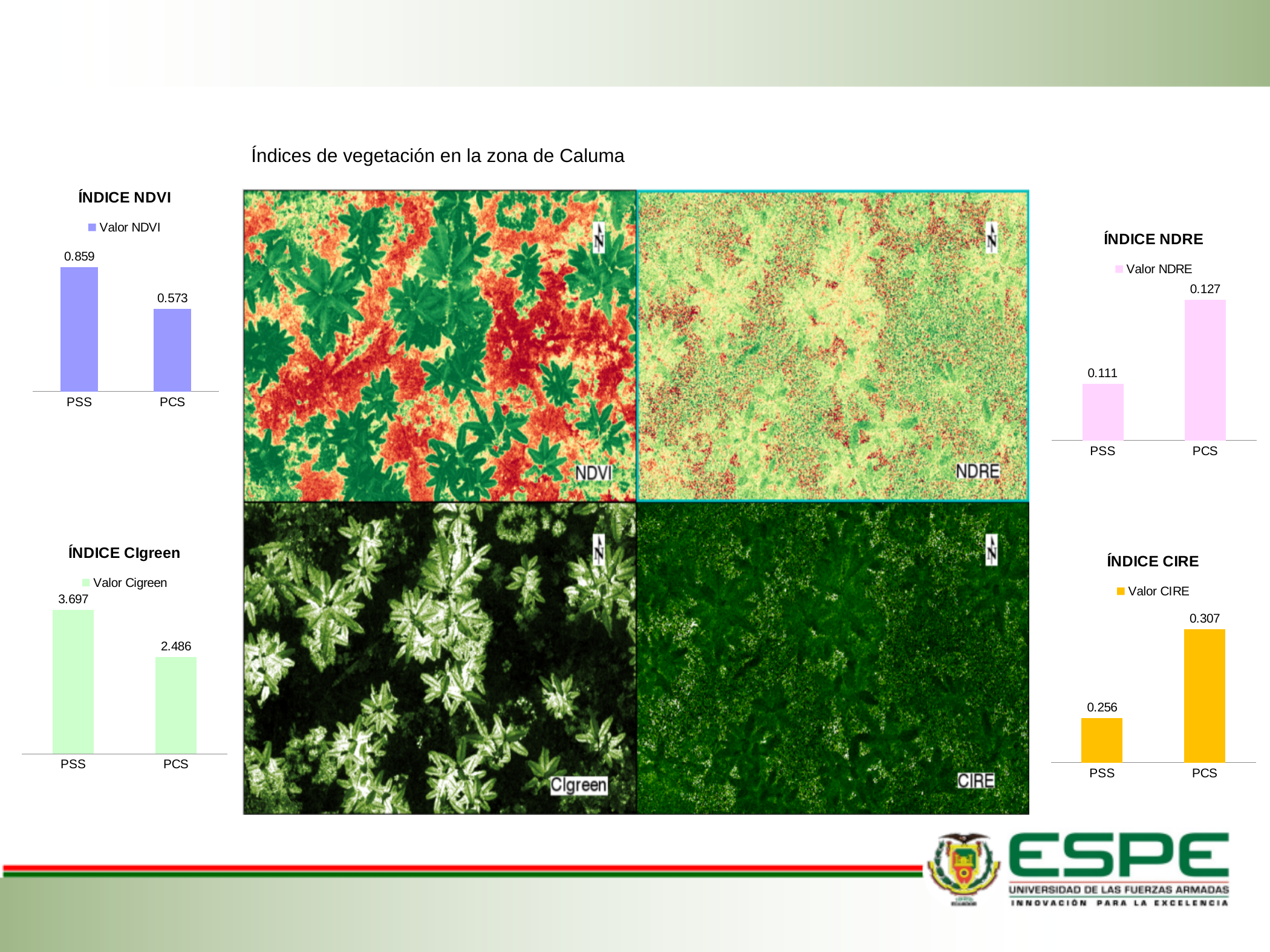
What kind of chart is the ÍNDICE NDVI chart? Bar chart In the ÍNDICE CIgreen chart, which category has the lowest value? PCS In the ÍNDICE CIgreen chart, what is the value for PSS? 3.697 In the ÍNDICE CIRE chart, which is larger, the value for PSS or the value for PCS? PCS In the ÍNDICE NDVI chart, what is the value for PCS? 0.573 In the ÍNDICE CIRE chart, what is the value for PCS? 0.307 In the ÍNDICE CIgreen chart, what is the difference between the PSS and PCS values? 1.211 In the ÍNDICE NDRE chart, which category has the highest value? PCS What series name does the legend of the ÍNDICE NDRE chart show? Valor NDRE In the ÍNDICE NDVI chart, what is the value for PSS? 0.859 In the ÍNDICE NDRE chart, what is the difference between the PCS and PSS values? 0.016 How many categories does the ÍNDICE CIRE chart show? 2